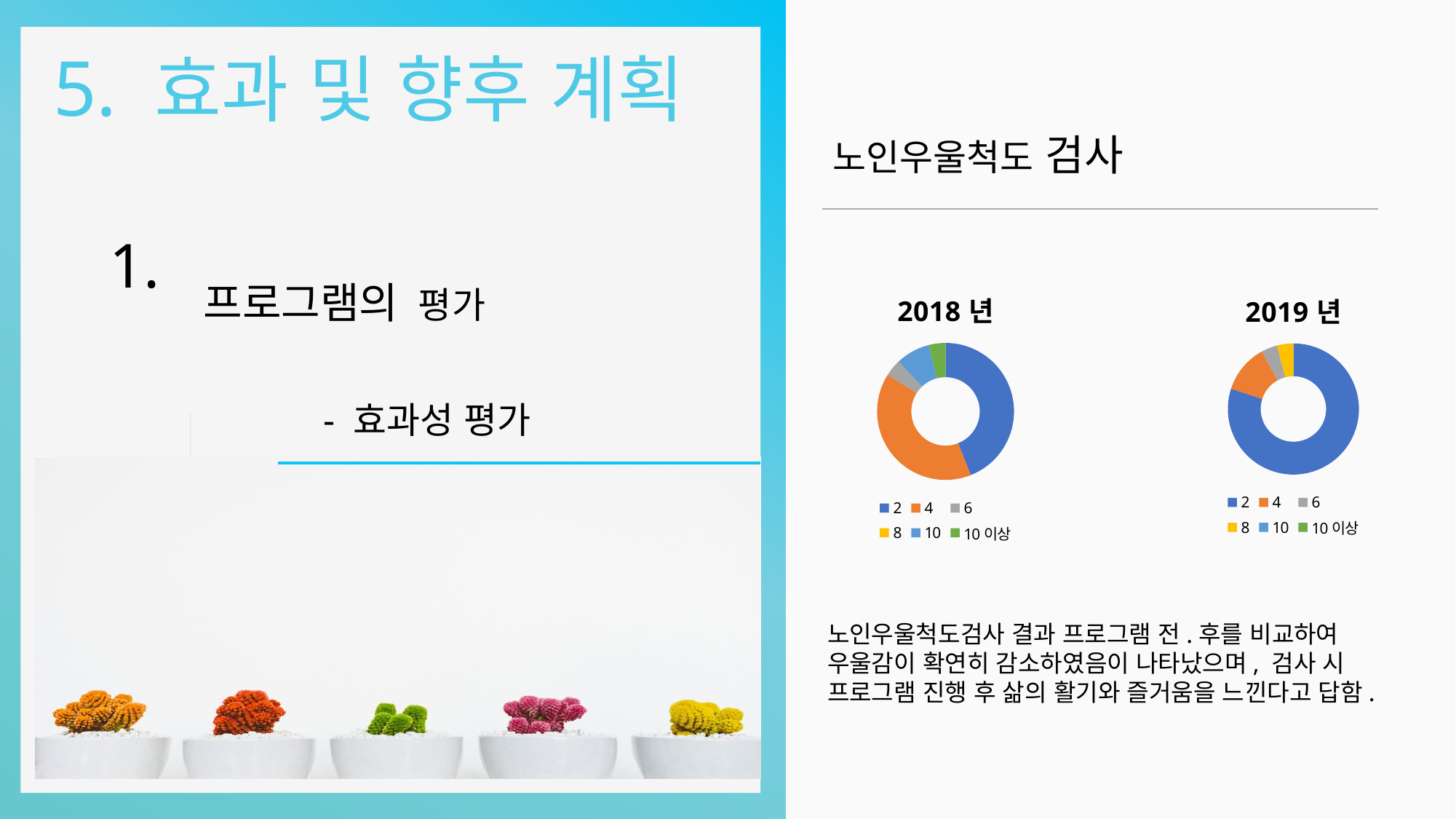
How many entries does the legend of the "2019 년" chart list? 6 How many entries does the legend of the "2018 년" chart list? 6 What is the title of the left doughnut chart? 2018 년 In the "2019 년" chart, which category has the largest slice? 2 What colour represents the category "10 이상" in the chart legends? Green Is the share of the slice for 4 larger in the "2018 년" chart or in the "2019 년" chart? 2018 년 In the "2018 년" chart, which slice is larger, the one for 2 or the one for 6? 2 In the "2018 년" chart, which slice is larger, the one for 4 or the one for 10? 4 What kind of chart is the "2018 년" chart? Doughnut chart What kind of chart is the "2019 년" chart? Doughnut chart